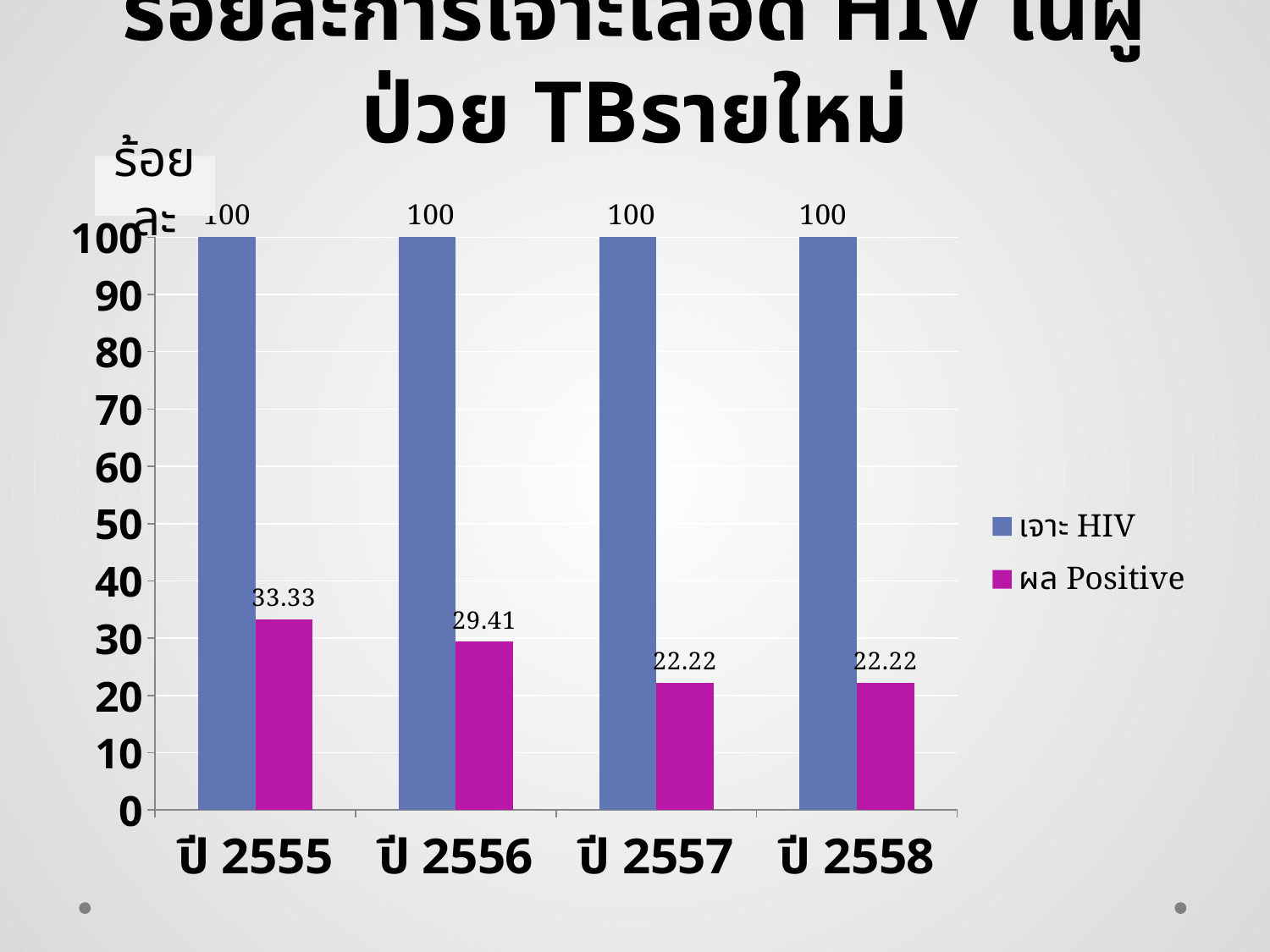
What is the value for ผล Positive in ปี 2555? 33.33 Which year has the highest value for ผล Positive? ปี 2555 Do the ผล Positive values rise or fall from ปี 2555 to ปี 2557? fall What is the difference between the เจาะ HIV and ผล Positive values in ปี 2557? 77.78 What is the difference between the ผล Positive values for ปี 2555 and ปี 2556? 3.92 How many years are shown on the x axis? 4 Which is larger, the ผล Positive value for ปี 2556 or for ปี 2557? ปี 2556 What kind of chart is shown on the slide? bar chart What is the value for ผล Positive in ปี 2556? 29.41 What is the value for ผล Positive in ปี 2558? 22.22 How many series does the legend list? 2 What is the value for เจาะ HIV in ปี 2557? 100